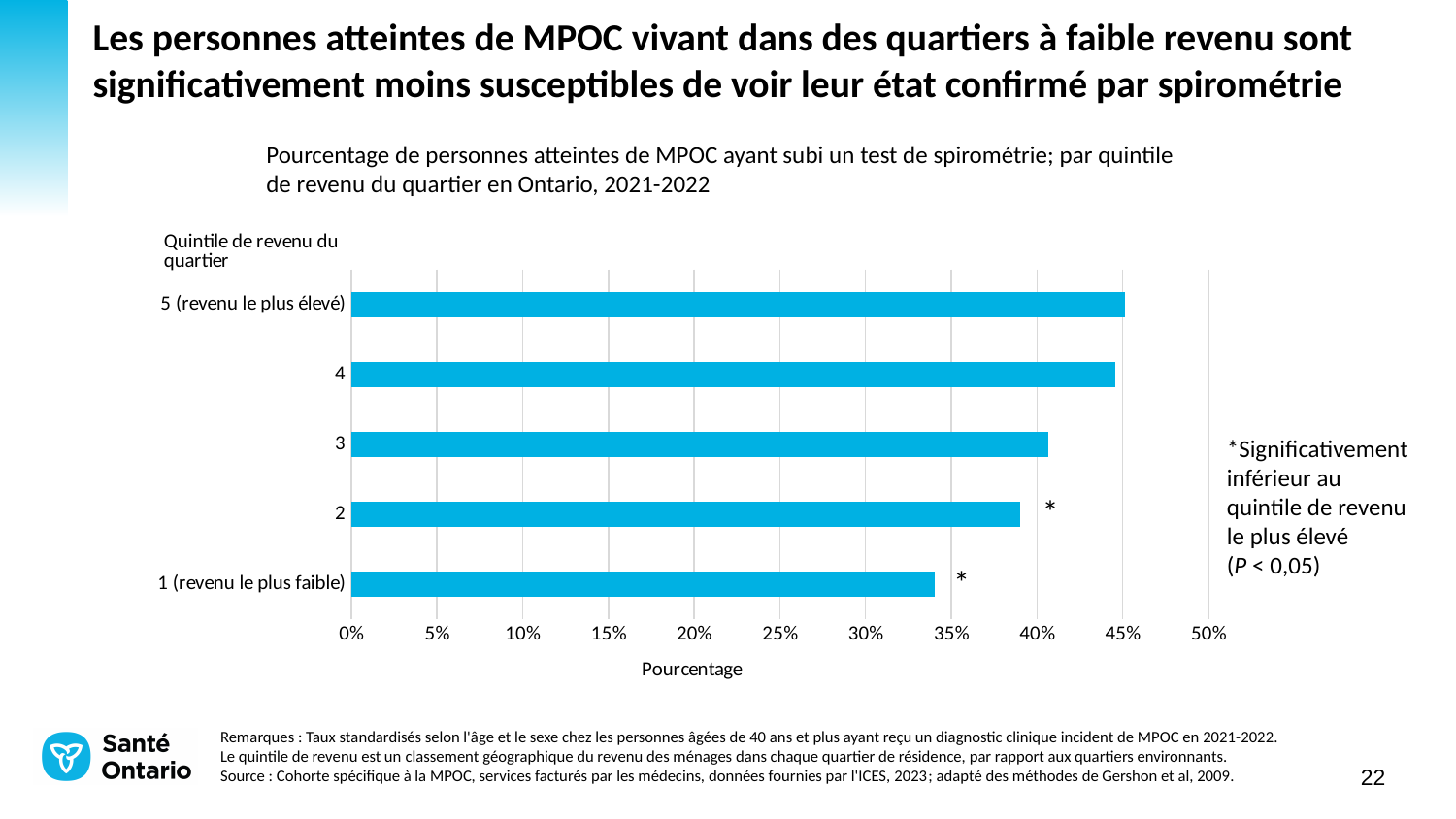
Which quintiles are marked with an asterisk as significantly lower than the highest income quintile? 2 and 1 (revenu le plus faible) Is the value for quintile 3 greater or less than 40%? greater How many income quintile categories are plotted in the chart? 5 Which is larger, the value for quintile 4 or the value for quintile 3? 4 Is the value for quintile 1 (revenu le plus faible) greater or less than 30%? greater Do the percentages rise or fall as the income quintile increases from 1 to 5? rise Which income quintile has the lowest percentage of people with COPD who had a spirometry test? 1 (revenu le plus faible) Which is larger, the value for quintile 5 (revenu le plus élevé) or the value for quintile 1 (revenu le plus faible)? 5 (revenu le plus élevé) What kind of chart is shown on the slide? Bar chart Is the value for quintile 5 (revenu le plus élevé) greater or less than 40%? greater